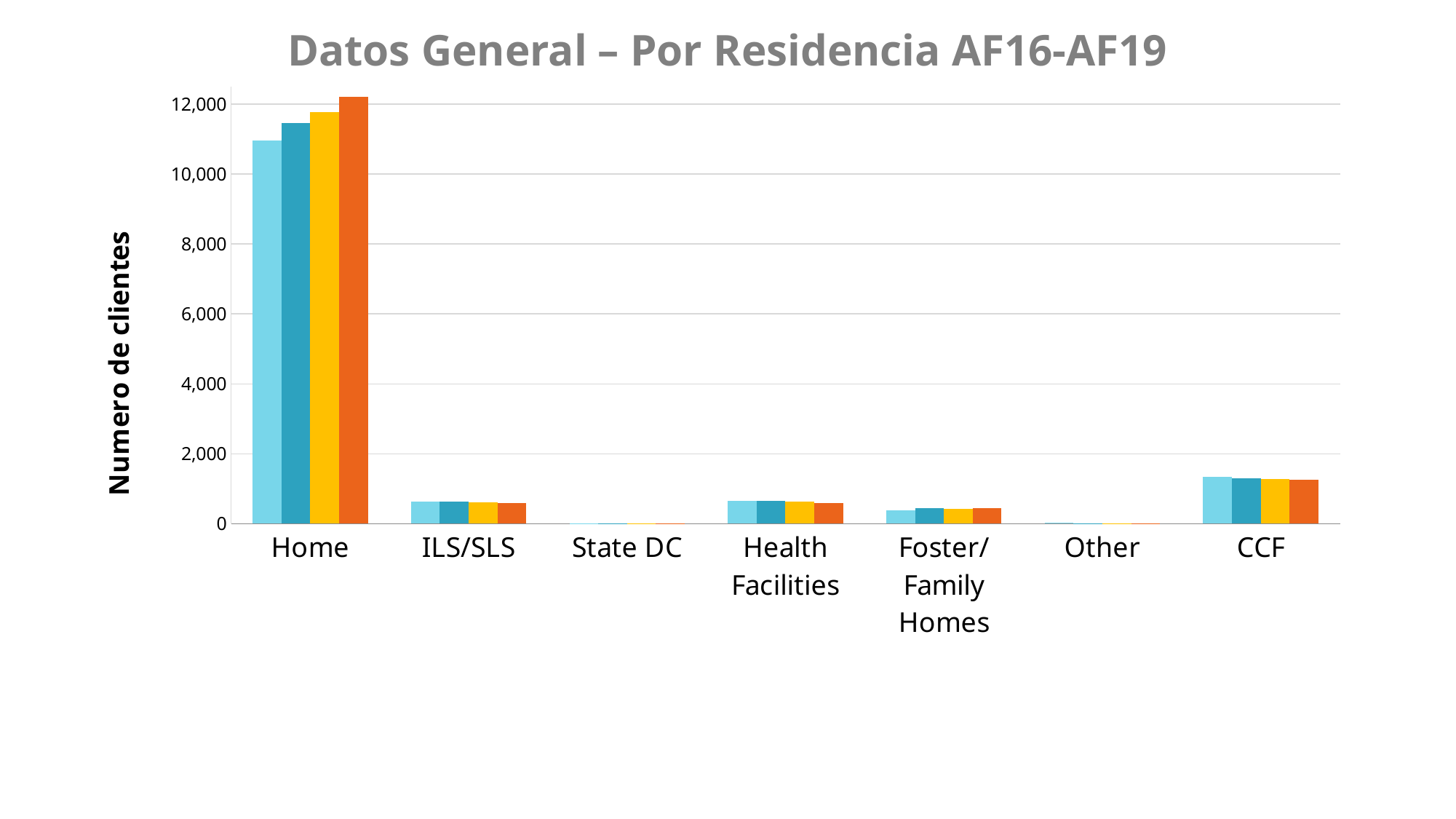
Are the values for Home greater or less than 10,000? greater What kind of chart is shown on the slide? bar chart Within the Home category, do the bars rise or fall from left to right? rise Which residence category has the highest number of clients? Home What is the label on the vertical axis of the chart? Numero de clientes Which category has higher values, CCF or ILS/SLS? CCF Are the values for CCF greater or less than 2,000? less How many residence categories are shown on the x axis? 7 How many bars are plotted for each residence category? 4 Which category has higher values, Home or Health Facilities? Home What is the title of the chart? Datos General – Por Residencia AF16-AF19 Are the values for ILS/SLS greater or less than 2,000? less